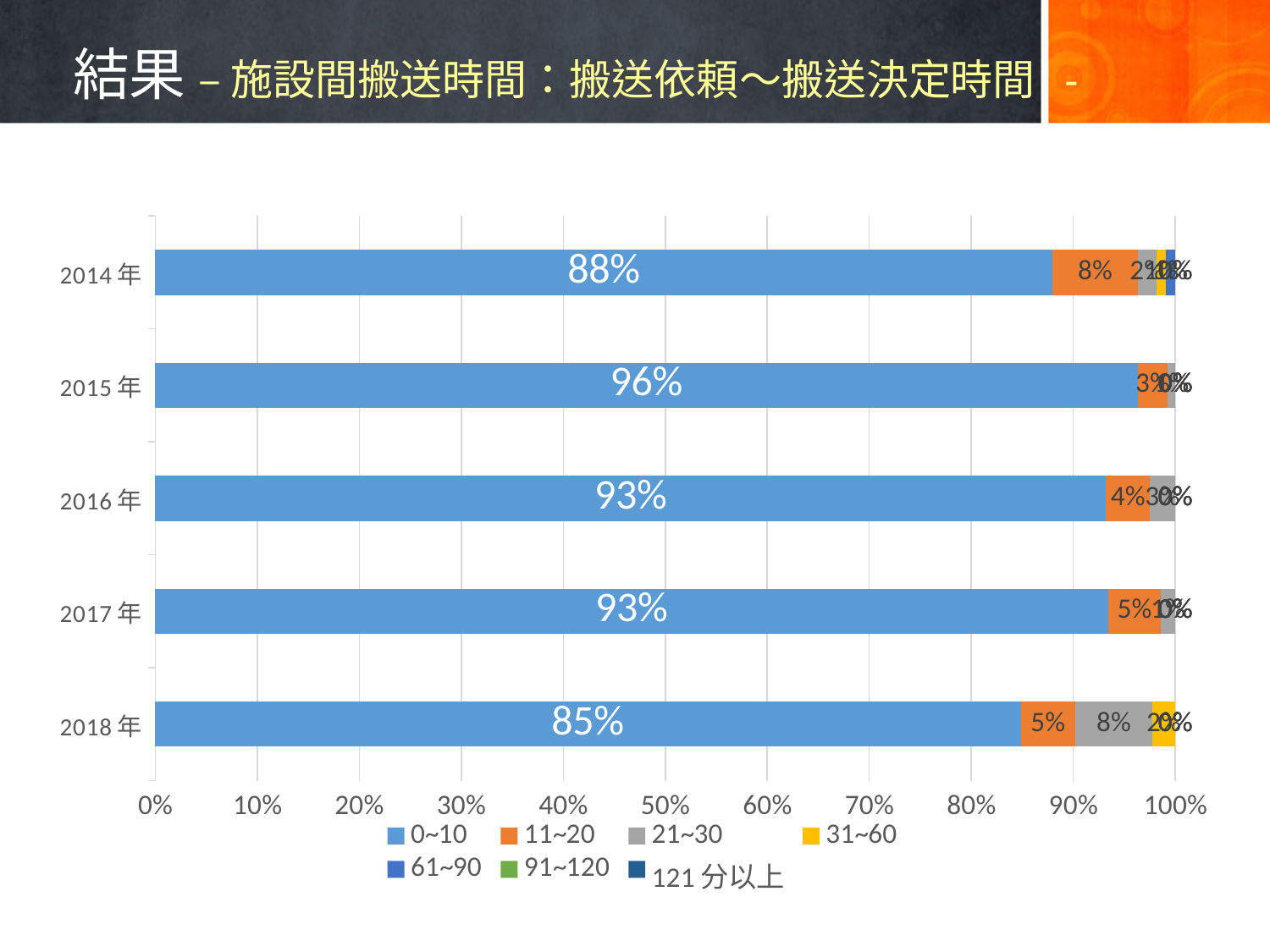
What kind of chart is shown on the slide? Stacked bar chart How many series does the legend list? 7 What is the value of the 0~10 series for 2018年? 85% Which colour represents the 0~10 series in the legend? Blue Which year has the highest value for the 0~10 series? 2015年 What is the value of the 0~10 series for 2015年? 96% What is the value of the 11~20 series for 2014年? 8% What is the difference between the 0~10 values for 2015年 and 2018年? 11% What is the value of the 21~30 series for 2018年? 8% Which is larger, the 0~10 value for 2014年 or for 2016年? 2016年 Which year has the lowest value for the 0~10 series? 2018年 How many years are shown on the chart? 5